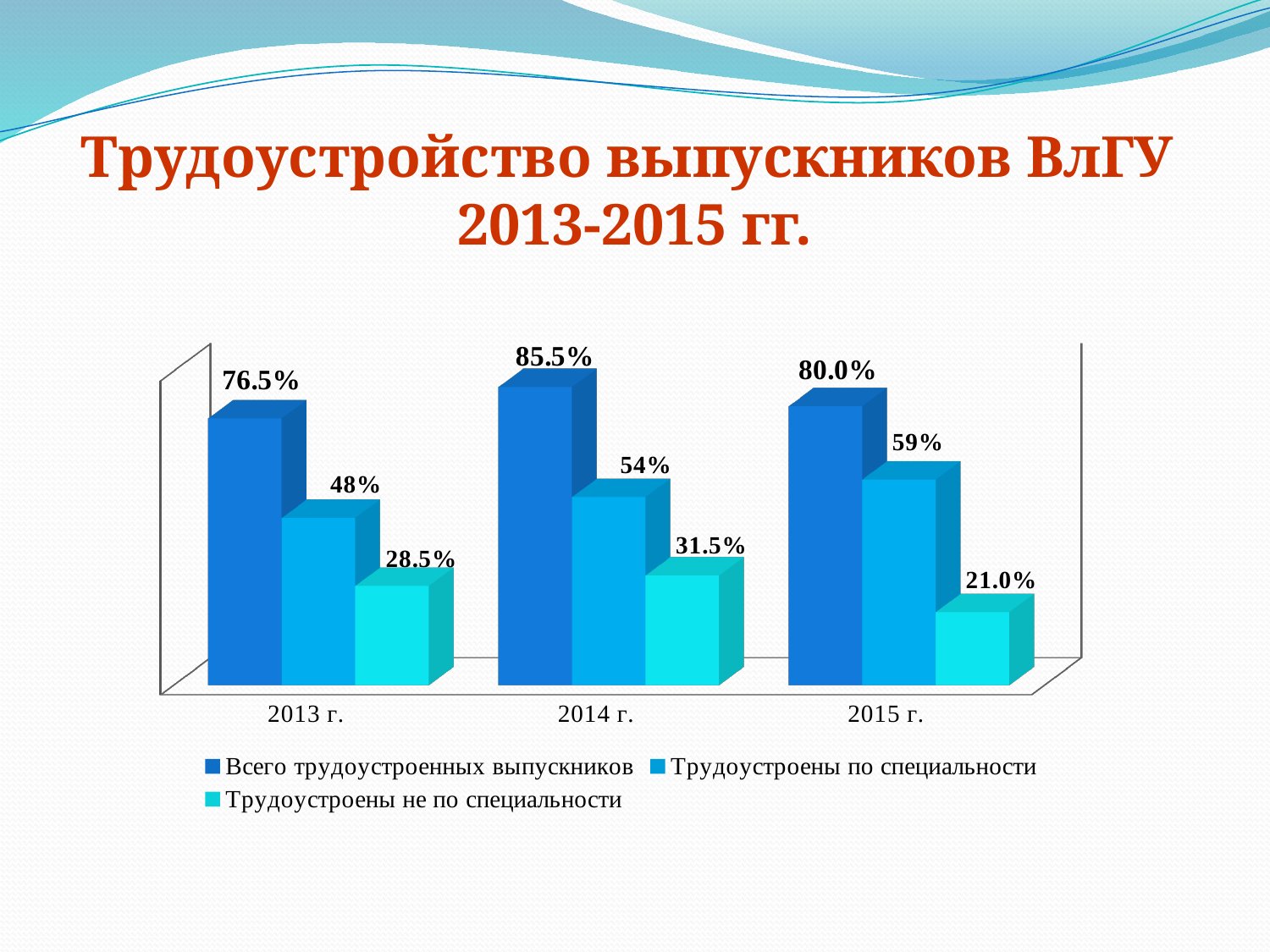
What is the difference between "Всего трудоустроенных выпускников" in 2014 г. and in 2013 г.? 9% What is the value for "Трудоустроены не по специальности" in 2015 г.? 21.0% What is the value for "Трудоустроены по специальности" in 2015 г.? 59% What kind of chart is shown on the slide? bar chart What is the value for "Всего трудоустроенных выпускников" in 2014 г.? 85.5% Which is larger: "Трудоустроены по специальности" in 2014 г. or in 2015 г.? 2015 г. Does "Трудоустроены по специальности" rise or fall from 2013 г. to 2015 г.? rise In which year is "Трудоустроены не по специальности" lowest? 2015 г. What is the value for "Трудоустроены по специальности" in 2013 г.? 48% How many years are shown on the x axis? 3 In which year is "Всего трудоустроенных выпускников" highest? 2014 г. How many series does the legend list? 3